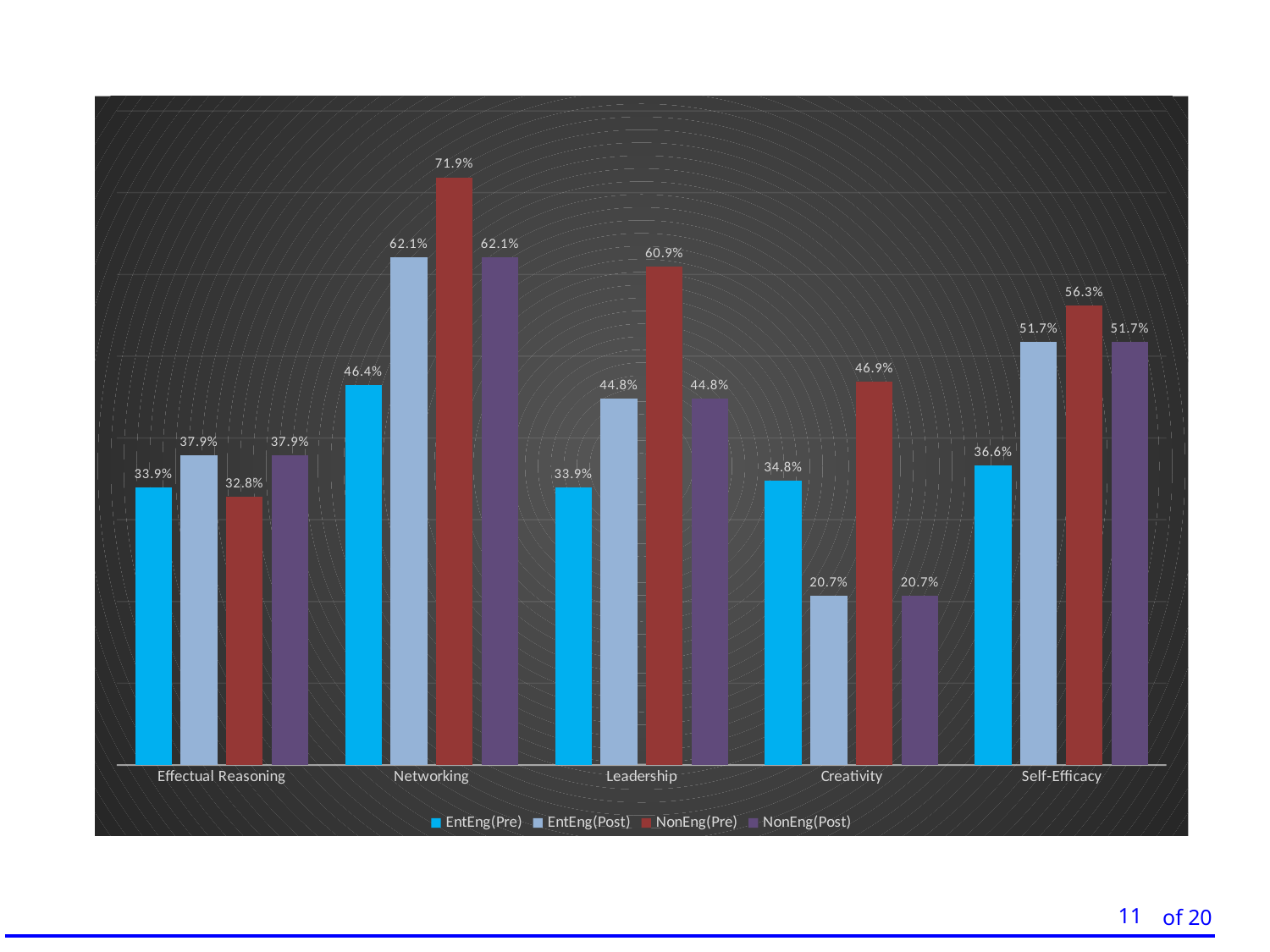
What is the difference between the NonEng(Pre) and EntEng(Pre) values in the Leadership category? 27.0% What is the value for EntEng(Post) in the Creativity category? 20.7% What kind of chart is shown on the slide? Bar chart What is the value for NonEng(Pre) in the Networking category? 71.9% In the Effectual Reasoning category, which is larger: EntEng(Pre) or NonEng(Pre)? EntEng(Pre) How many series does the legend list? 4 What is the value for EntEng(Pre) in the Self-Efficacy category? 36.6% How many categories are shown on the x axis? 5 Which category has the highest NonEng(Pre) value? Networking What is the value for NonEng(Post) in the Leadership category? 44.8% In the Creativity category, which is larger: EntEng(Pre) or NonEng(Pre)? NonEng(Pre) Which category has the lowest EntEng(Post) value? Creativity